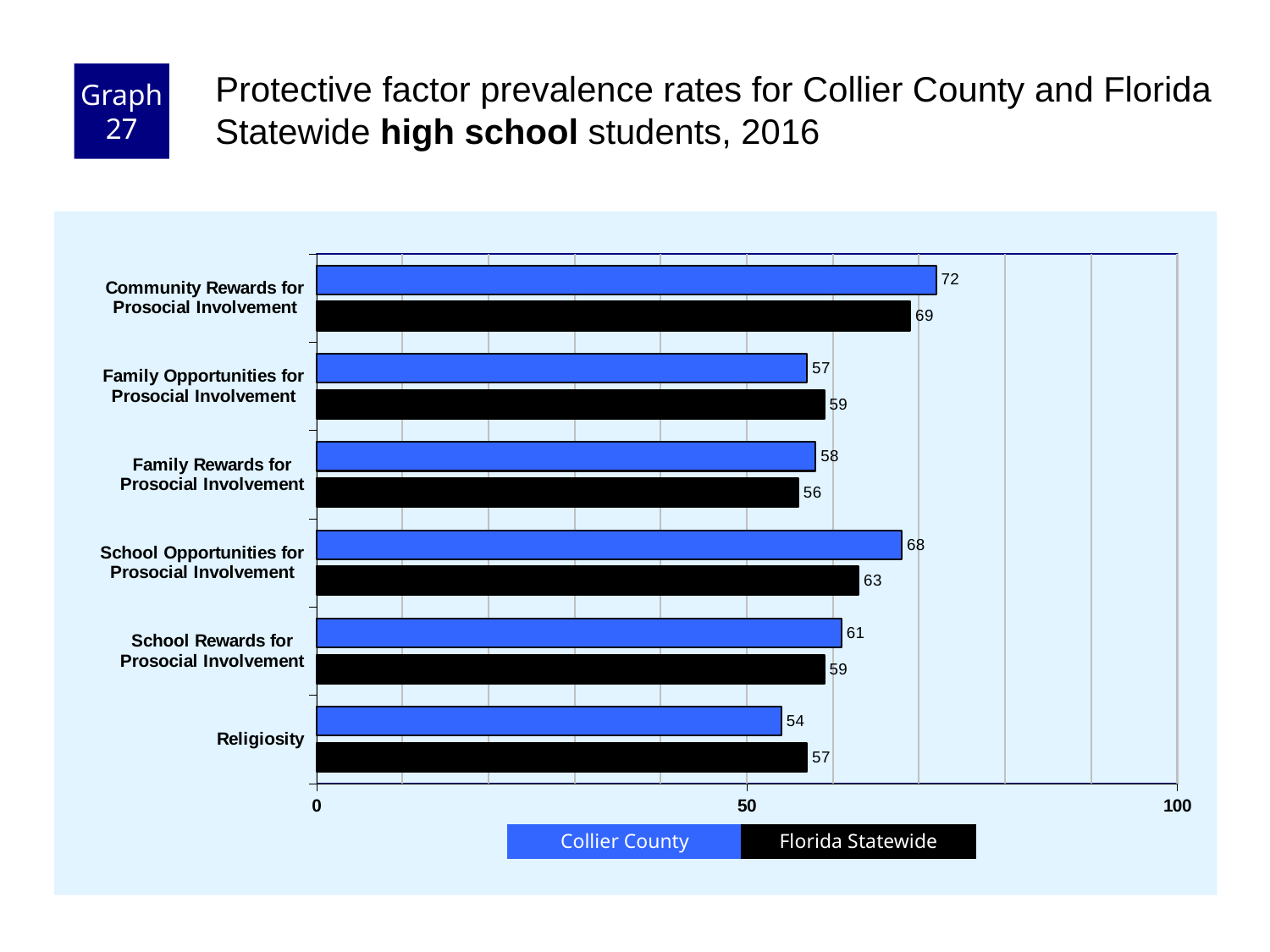
What is the difference between the Collier County and Florida Statewide values for School Opportunities for Prosocial Involvement? 5 Is the Collier County value for Religiosity greater or less than 50? greater How many categories are shown on the chart? 6 Which colour represents Florida Statewide in the chart? Black Which is larger for Family Opportunities for Prosocial Involvement: the Collier County value or the Florida Statewide value? Florida Statewide What is the Florida Statewide value for Religiosity? 57 What is the Collier County value for Community Rewards for Prosocial Involvement? 72 Which category has the highest Collier County value? Community Rewards for Prosocial Involvement Which category has the lowest Collier County value? Religiosity What is the Florida Statewide value for School Opportunities for Prosocial Involvement? 63 What kind of chart is shown on the slide? Bar chart How many series does the legend list? 2